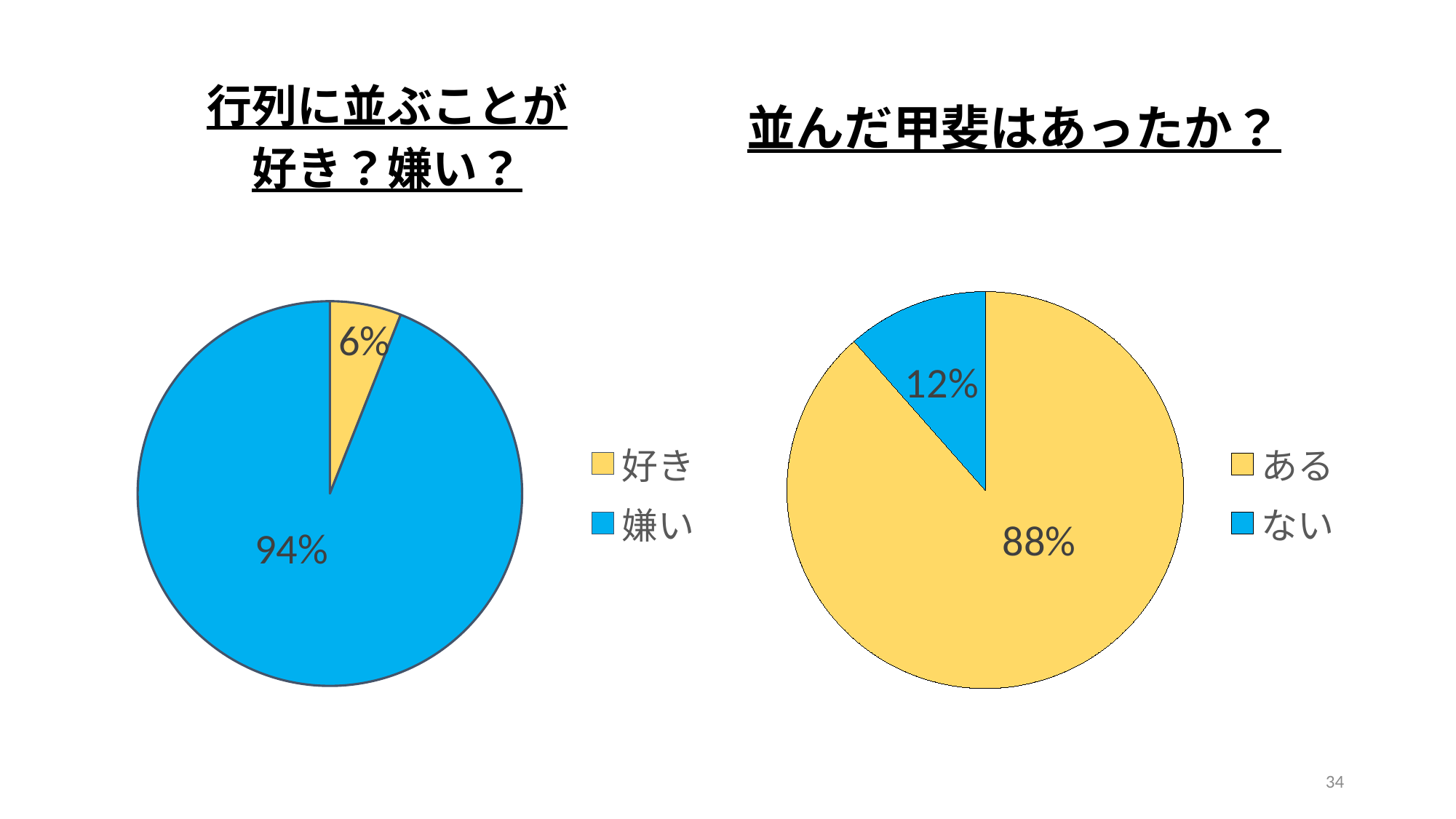
In the right chart (並んだ甲斐はあったか？), what percentage is shown for ある? 88% In the right chart (並んだ甲斐はあったか？), which category has the smallest slice? ない In the right chart (並んだ甲斐はあったか？), which is larger, ある or ない? ある In the left chart (行列に並ぶことが好き？嫌い？), what percentage is shown for 好き? 6% In the right chart (並んだ甲斐はあったか？), what is the difference in percentage points between ある and ない? 76 In the left chart (行列に並ぶことが好き？嫌い？), what percentage is shown for 嫌い? 94% In the right chart (並んだ甲斐はあったか？), what percentage is shown for ない? 12% In the left chart (行列に並ぶことが好き？嫌い？), which category has the largest slice? 嫌い How many categories does the legend of the right chart (並んだ甲斐はあったか？) list? 2 What type of chart is the left chart (行列に並ぶことが好き？嫌い？)? pie chart In the left chart (行列に並ぶことが好き？嫌い？), what colour is the 好き slice? yellow In the left chart (行列に並ぶことが好き？嫌い？), what is the difference in percentage points between 嫌い and 好き? 88